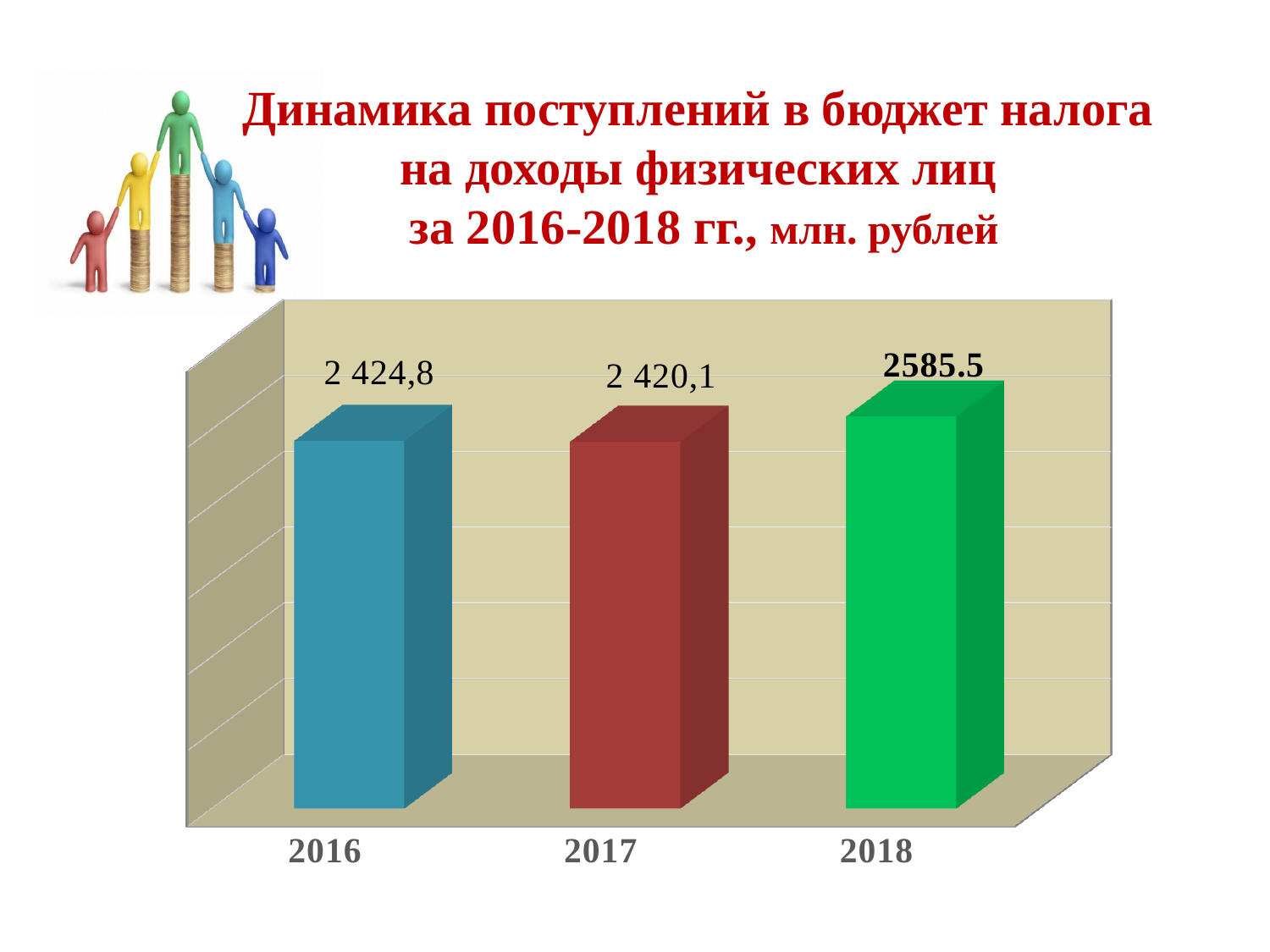
What colour is the bar for 2018? green What is the value for 2018? 2585.5 What is the difference between the values for 2016 and 2017? 4,7 Which is larger, the value for 2016 or the value for 2017? 2016 How many years are shown on the chart? 3 What kind of chart is shown on the slide? bar chart Which year has the highest value? 2018 Which is larger, the value for 2018 or the value for 2016? 2018 In what units are the values given, according to the title? млн. рублей What is the value for 2016? 2 424,8 Which year has the lowest value? 2017 What is the value for 2017? 2 420,1